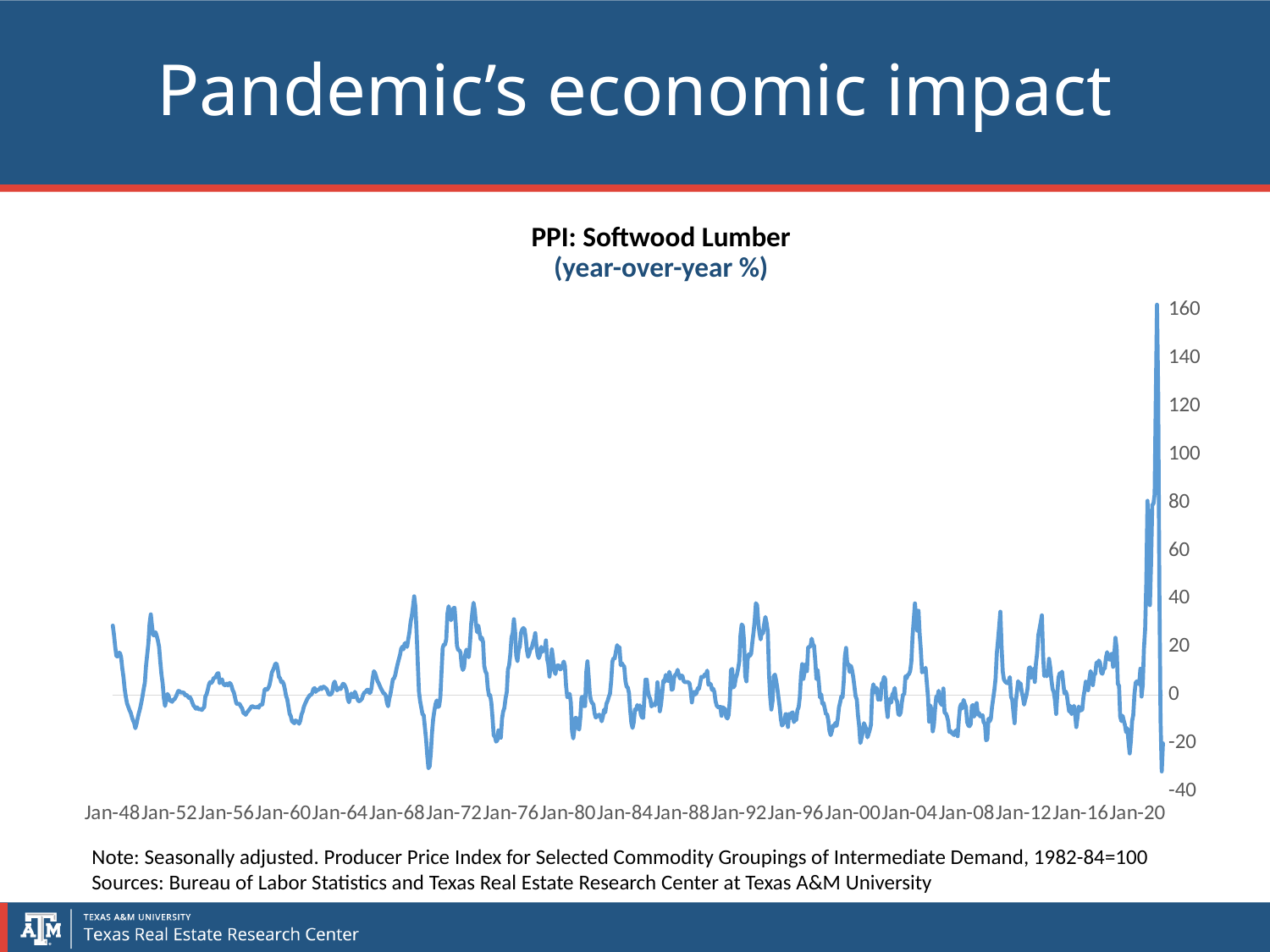
In which period does the line reach its highest value? after Jan-20 Which is larger: the peak value after Jan-20 or the peak value around Jan-68? the peak after Jan-20 Is the peak value around Jan-68 greater or less than 60? less How many data series are plotted on the chart? 1 Is the highest value reached by the line greater or less than 140? greater What is the title of the chart? PPI: Softwood Lumber (year-over-year %) Is the lowest value reached by the line greater or less than -20? less What kind of chart is shown on the slide? line chart What is the first date label on the horizontal axis? Jan-48 What is the highest value shown on the vertical axis? 160 What is the last date label on the horizontal axis? Jan-20